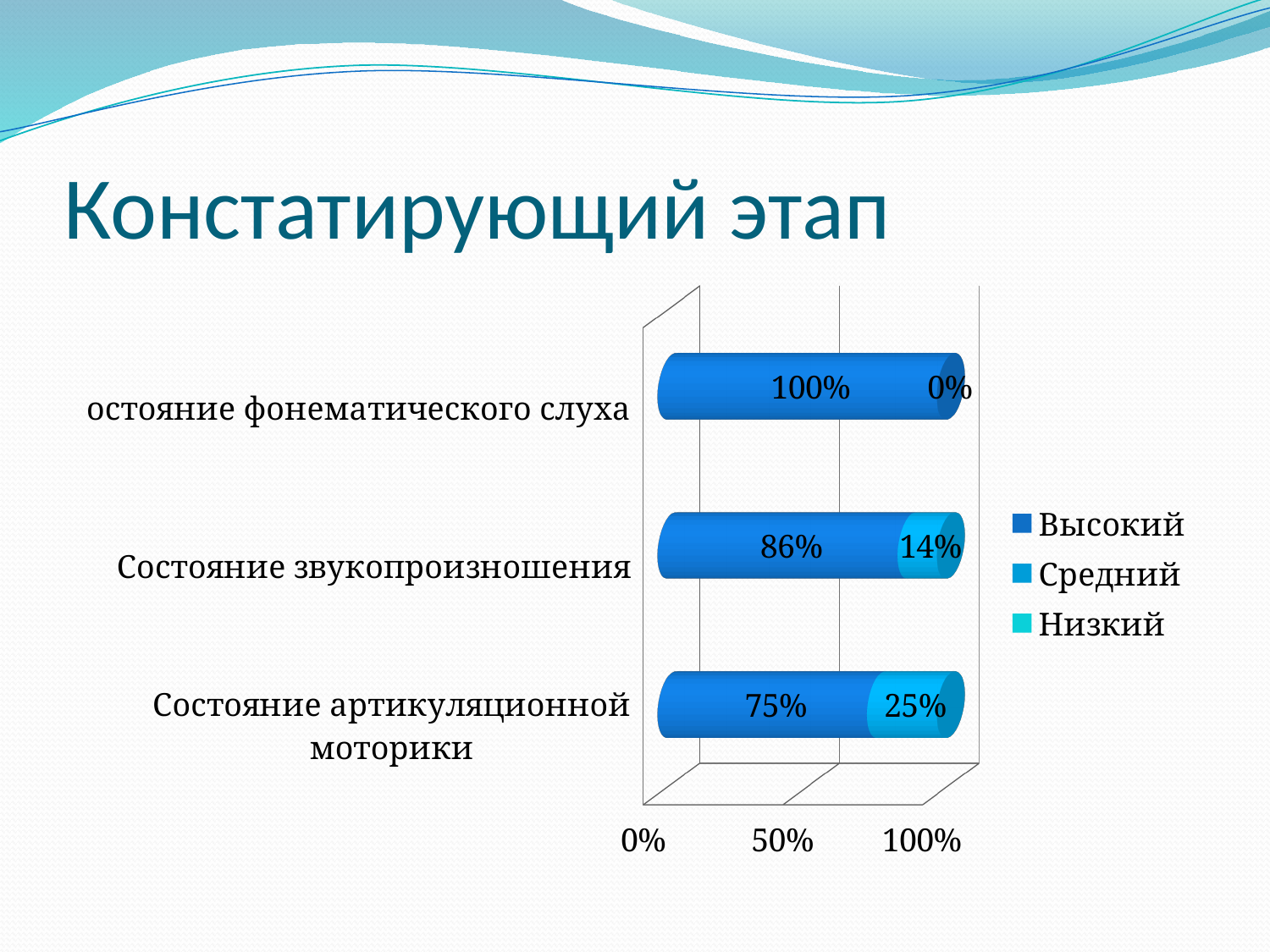
How many series does the legend list? 3 Which is larger: the Высокий value for Состояние звукопроизношения or for Состояние артикуляционной моторики? Состояние звукопроизношения Which category has the highest Высокий value? остояние фонематического слуха What is the value of the Высокий series for Состояние звукопроизношения? 86% What is the value of the Высокий series for Состояние артикуляционной моторики? 75% What are the legend entries of the chart? Высокий, Средний, Низкий What kind of chart is shown on the slide? bar chart What is the total of the two labelled segments in the bar for Состояние артикуляционной моторики? 100% What is the value of the Высокий series for the фонематического слуха category? 100% How many categories are shown on the chart? 3 What is the difference between the Высокий values for Состояние звукопроизношения and Состояние артикуляционной моторики? 11% Which category has the lowest Высокий value? Состояние артикуляционной моторики